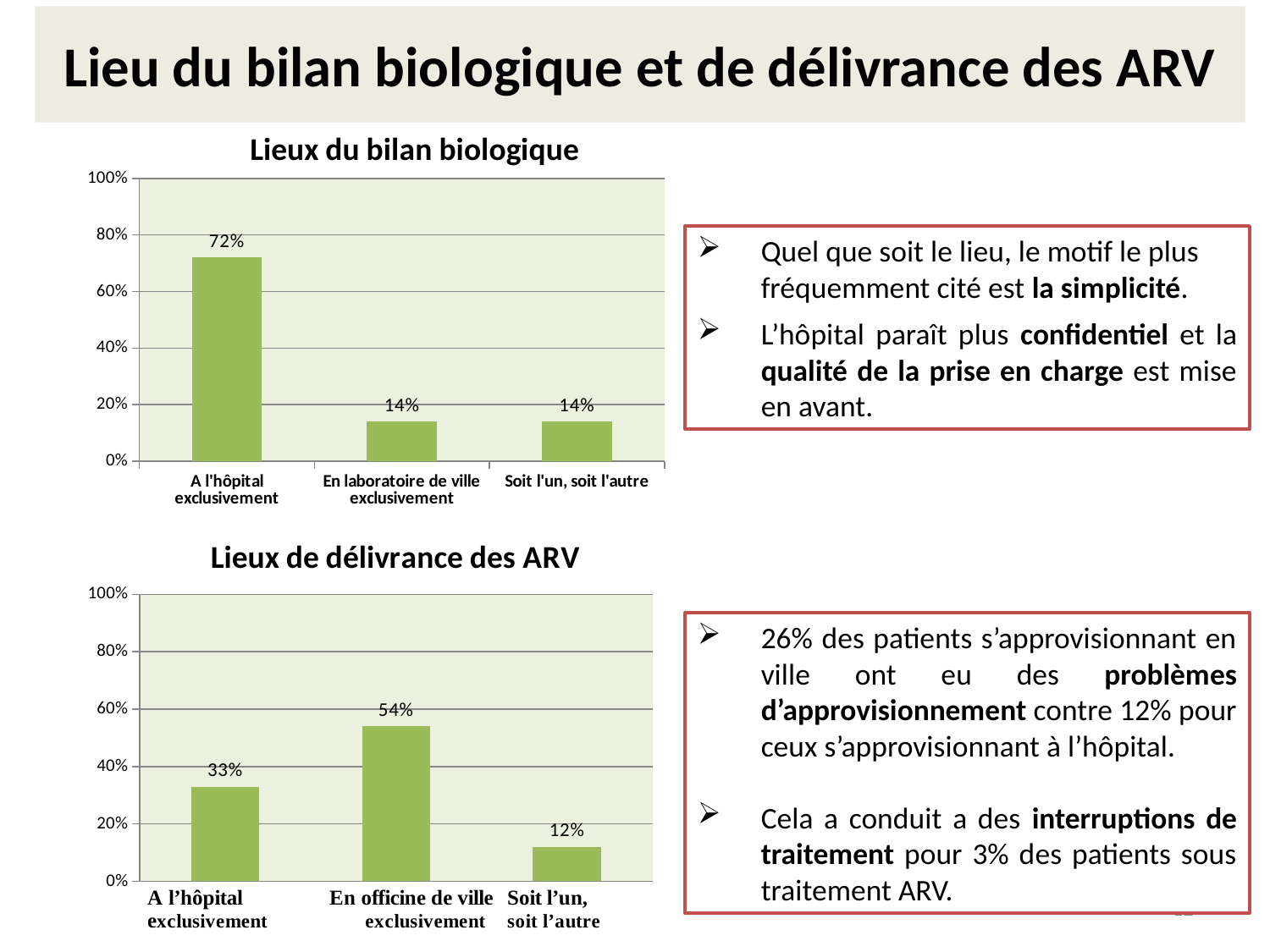
In the 'Lieux de délivrance des ARV' chart, is the value for 'A l'hôpital exclusivement' greater or less than 40%? less What type of chart is the 'Lieux de délivrance des ARV' chart? Bar chart In the 'Lieux de délivrance des ARV' chart, what is the value for 'En officine de ville exclusivement'? 54% In the 'Lieux du bilan biologique' chart, how many categories are shown? 3 In the 'Lieux du bilan biologique' chart, which category has the highest value? A l'hôpital exclusivement In the 'Lieux du bilan biologique' chart, what is the difference between 'A l'hôpital exclusivement' and 'Soit l'un, soit l'autre'? 58% In the 'Lieux de délivrance des ARV' chart, what is the value for 'Soit l'un, soit l'autre'? 12% In the 'Lieux du bilan biologique' chart, what is the value for 'A l'hôpital exclusivement'? 72% In the 'Lieux de délivrance des ARV' chart, which is larger: 'A l'hôpital exclusivement' or 'En officine de ville exclusivement'? En officine de ville exclusivement In the 'Lieux de délivrance des ARV' chart, which category has the lowest value? Soit l'un, soit l'autre In the 'Lieux de délivrance des ARV' chart, what is the difference between 'En officine de ville exclusivement' and 'A l'hôpital exclusivement'? 21% In the 'Lieux du bilan biologique' chart, what is the value for 'En laboratoire de ville exclusivement'? 14%